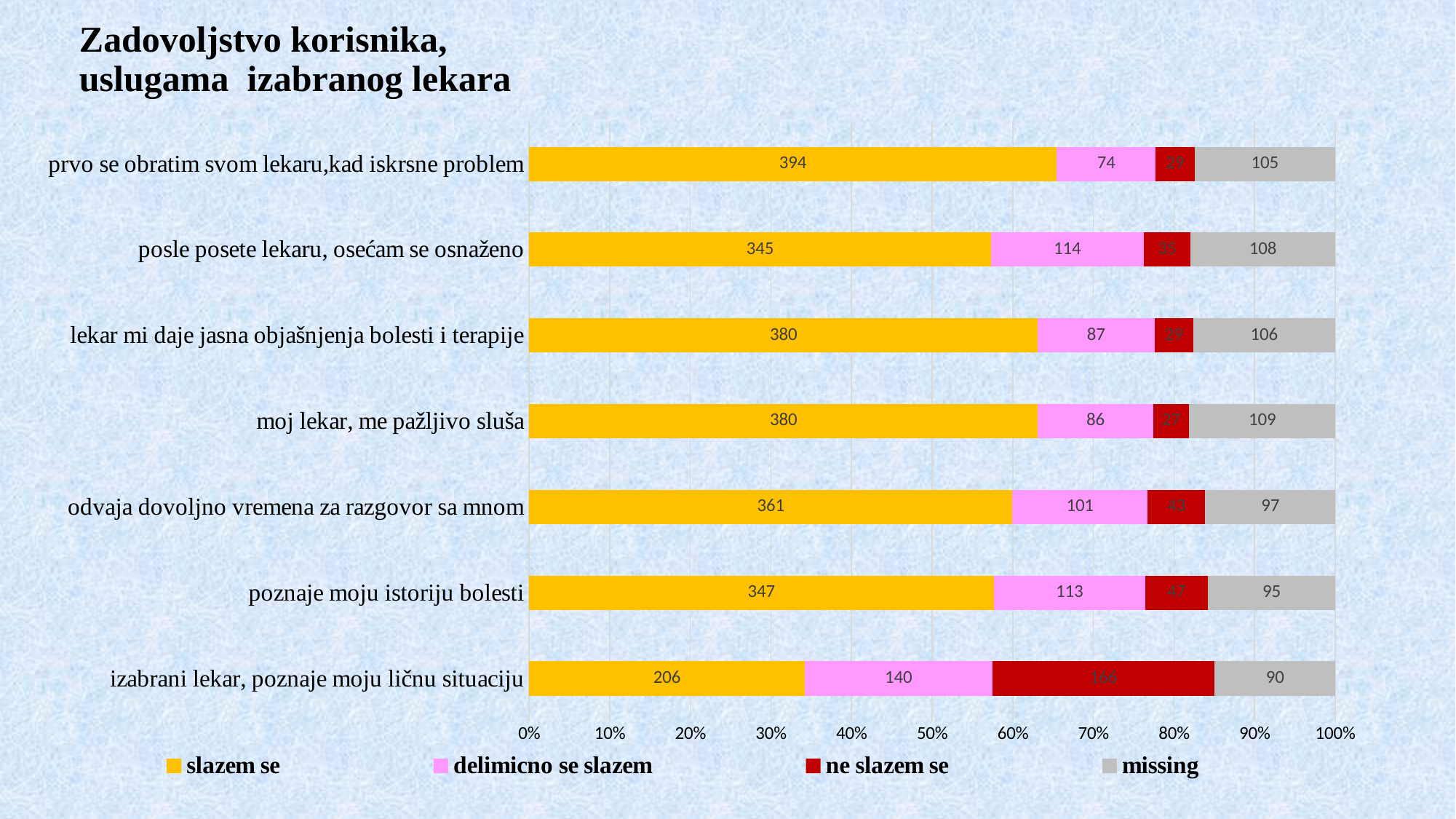
What is the 'missing' value for 'odvaja dovoljno vremena za razgovor sa mnom'? 97 What is the difference between the 'delimicno se slazem' values for 'izabrani lekar, poznaje moju ličnu situaciju' and 'prvo se obratim svom lekaru,kad iskrsne problem'? 66 What colour represents the 'ne slazem se' series in the legend? Red What is the 'slazem se' value for 'moj lekar, me pažljivo sluša'? 380 Which statement has the lowest 'slazem se' value? izabrani lekar, poznaje moju ličnu situaciju How many series does the legend list? 4 Which has the larger 'delimicno se slazem' value: 'posle posete lekaru, osećam se osnaženo' or 'lekar mi daje jasna objašnjenja bolesti i terapije'? posle posete lekaru, osećam se osnaženo How many categories (statements) are plotted on the chart? 7 Which statement has the highest 'delimicno se slazem' value? izabrani lekar, poznaje moju ličnu situaciju Which statement has the highest 'slazem se' value? prvo se obratim svom lekaru,kad iskrsne problem What is the 'delimicno se slazem' value for 'poznaje moju istoriju bolesti'? 113 What kind of chart is shown on the slide? Stacked bar chart